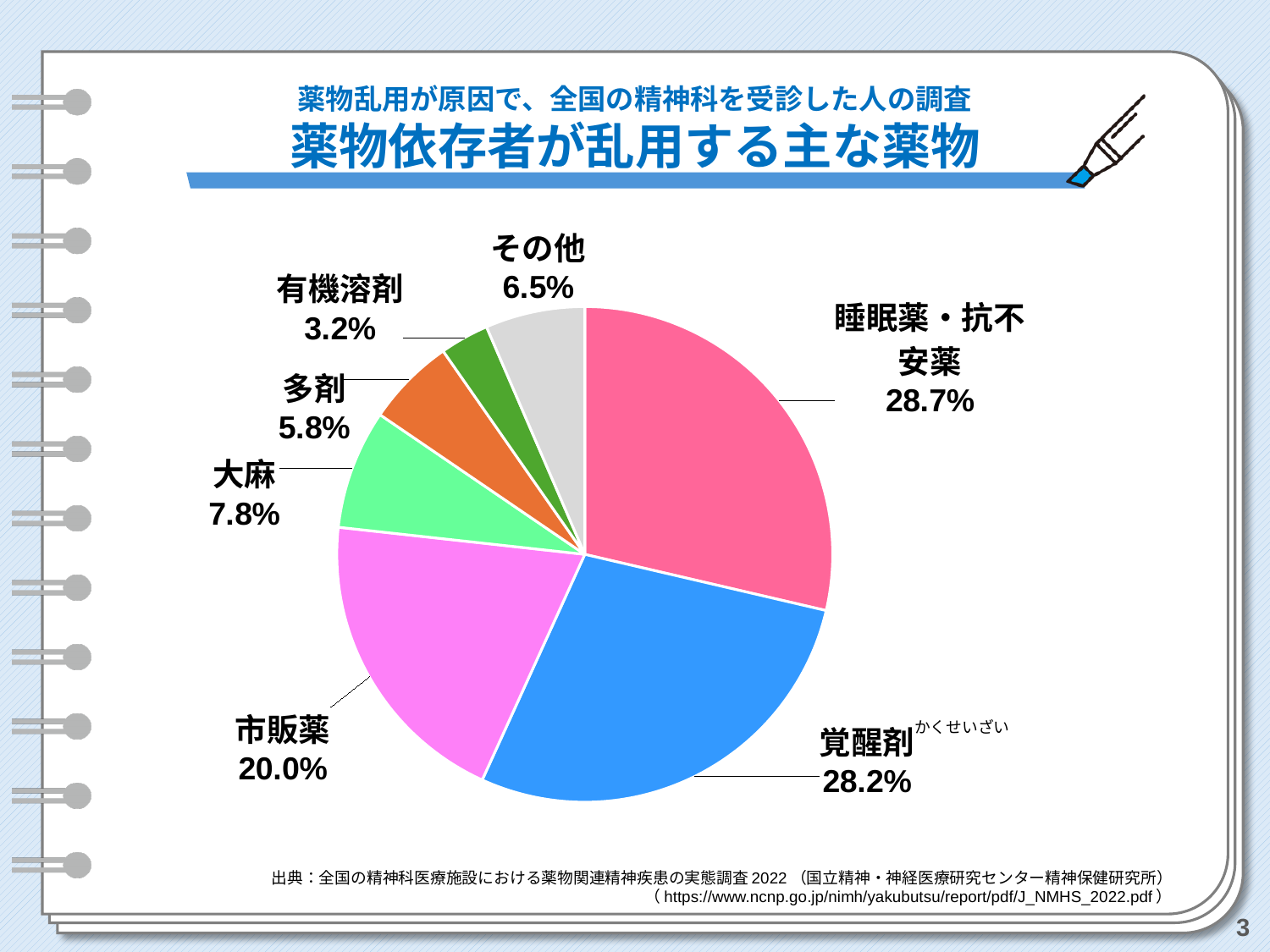
What percentage is shown for 多剤? 5.8% What percentage of the pie is 睡眠薬・抗不安薬? 28.7% How many categories are shown in the pie chart? 7 What share does 市販薬 have in the pie chart? 20.0% What is the value shown for 覚醒剤? 28.2% What kind of chart is shown on the slide? pie chart Which is larger, the slice for 多剤 or the slice for その他? その他 What is the value for 大麻? 7.8% What is the difference in percentage points between 市販薬 and 大麻? 12.2 Which category has the largest slice of the pie? 睡眠薬・抗不安薬 Which category has the smallest slice of the pie? 有機溶剤 What is the title of the chart on the slide? 薬物依存者が乱用する主な薬物